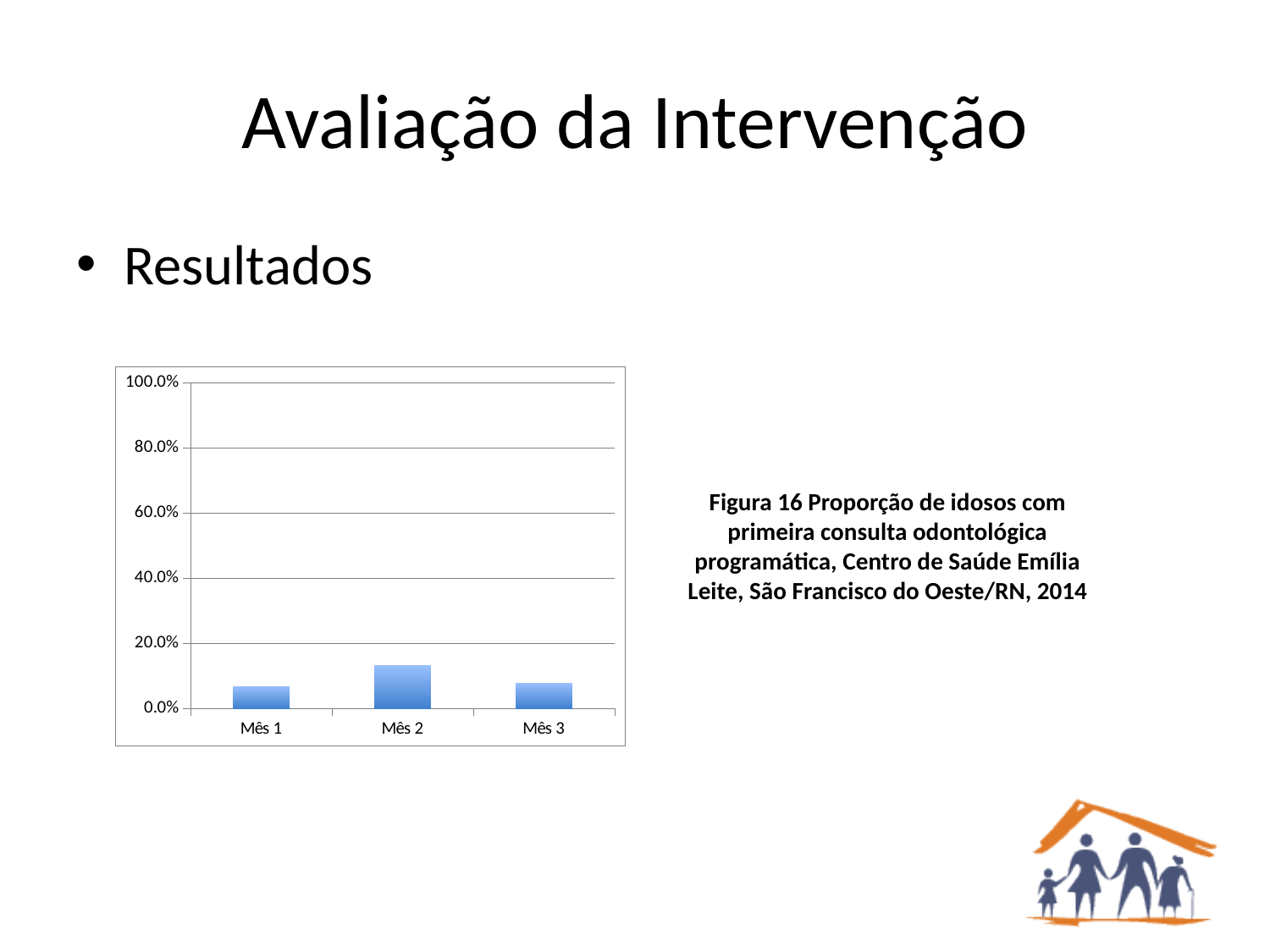
Is the value for Mês 3 greater or less than 40.0%? less Is the value for Mês 1 greater or less than 20.0%? less Which is larger, the value for Mês 2 or the value for Mês 3? Mês 2 Which is larger, the value for Mês 2 or the value for Mês 1? Mês 2 Which month has the highest bar in the chart? Mês 2 What kind of chart is shown on the slide? bar chart Do the values rise or fall from Mês 2 to Mês 3? fall How many categories (months) are shown on the x axis of the chart? 3 Is the value for Mês 2 greater or less than 20.0%? less What figure number is given in the caption next to the chart? Figura 16 Do the values rise or fall from Mês 1 to Mês 2? rise What is the highest value shown on the y axis of the chart? 100.0%